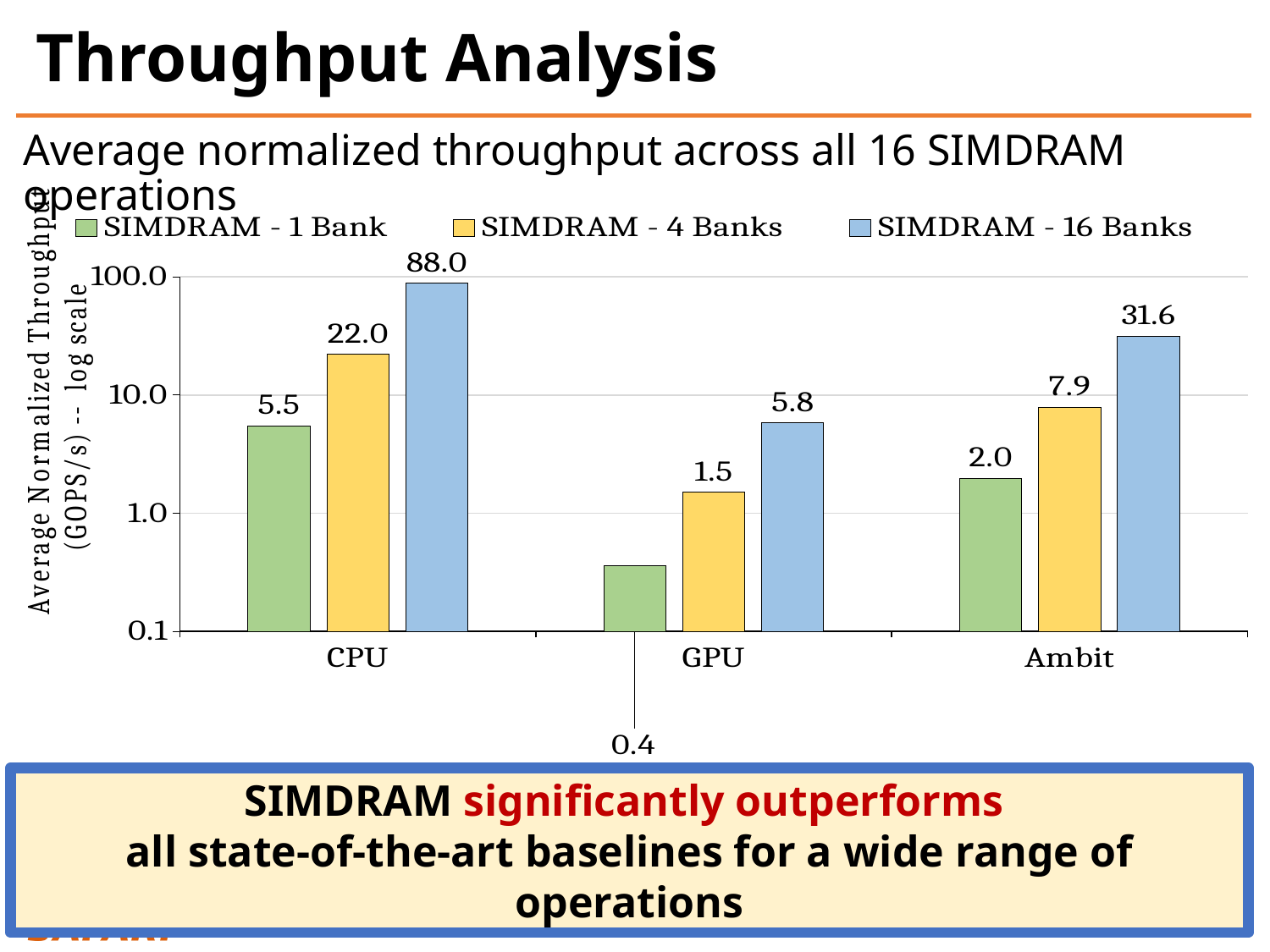
What is the value for SIMDRAM - 4 Banks in the Ambit category? 7.9 What is the value for SIMDRAM - 16 Banks in the CPU category? 88.0 How many categories are shown on the x axis? 3 How many series does the legend list? 3 Which is larger: the SIMDRAM - 16 Banks value for GPU or the SIMDRAM - 4 Banks value for Ambit? SIMDRAM - 4 Banks value for Ambit What is the difference between the SIMDRAM - 16 Banks and SIMDRAM - 4 Banks values for CPU? 66.0 What is the value for SIMDRAM - 1 Bank in the GPU category? 0.4 What colour represents SIMDRAM - 4 Banks in the legend? yellow Which category has the highest SIMDRAM - 16 Banks value? CPU What kind of chart is shown on the slide? bar chart Is the SIMDRAM - 16 Banks value for Ambit greater or less than 10.0? greater Which category has the lowest SIMDRAM - 1 Bank value? GPU